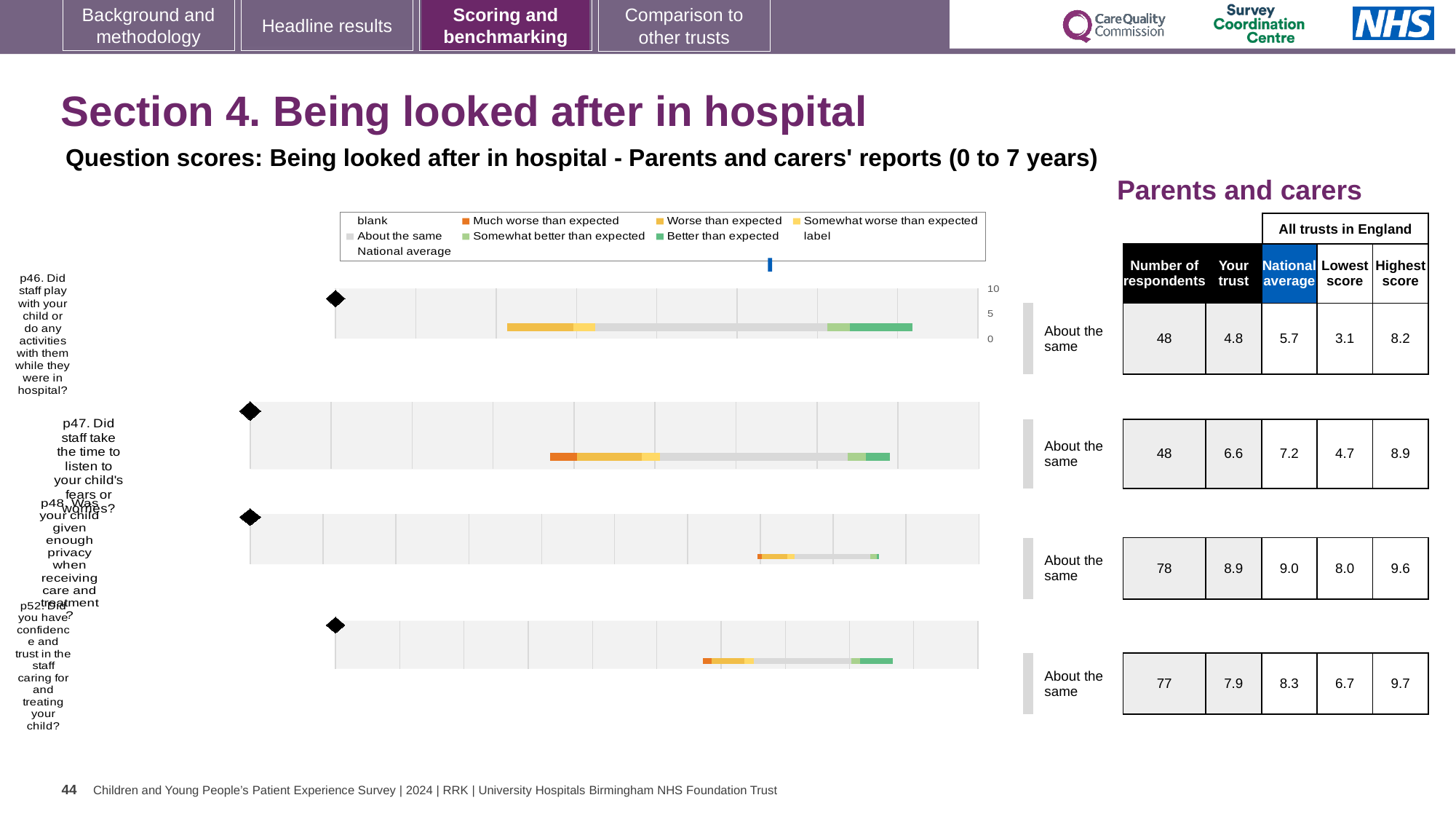
Which question has the highest 'Your trust' score on this slide? p48 According to the table beside the charts, how many respondents answered p52 (Did you have confidence and trust in the staff caring for and treating your child?)? 77 Which legend entry is shown in dark orange? Much worse than expected According to the table beside the charts, what is the national average for p47 (Did staff take the time to listen to your child's fears or worries?)? 7.2 How many survey questions (charts) are plotted on this slide? 4 For p52, which is larger: the 'Your trust' score or the national average? National average What kind of chart is used to show the question scores on this slide? bar chart What benchmark category is shown next to the chart for p46? About the same For p48, what is the difference between the highest score and the lowest score across all trusts in England? 1.6 Which question has the lowest 'Your trust' score on this slide? p46 For p46, how much higher is the national average than the 'Your trust' score? 0.9 According to the table beside the charts, what is the 'Your trust' score for p46 (Did staff play with your child or do any activities with them while they were in hospital?)? 4.8